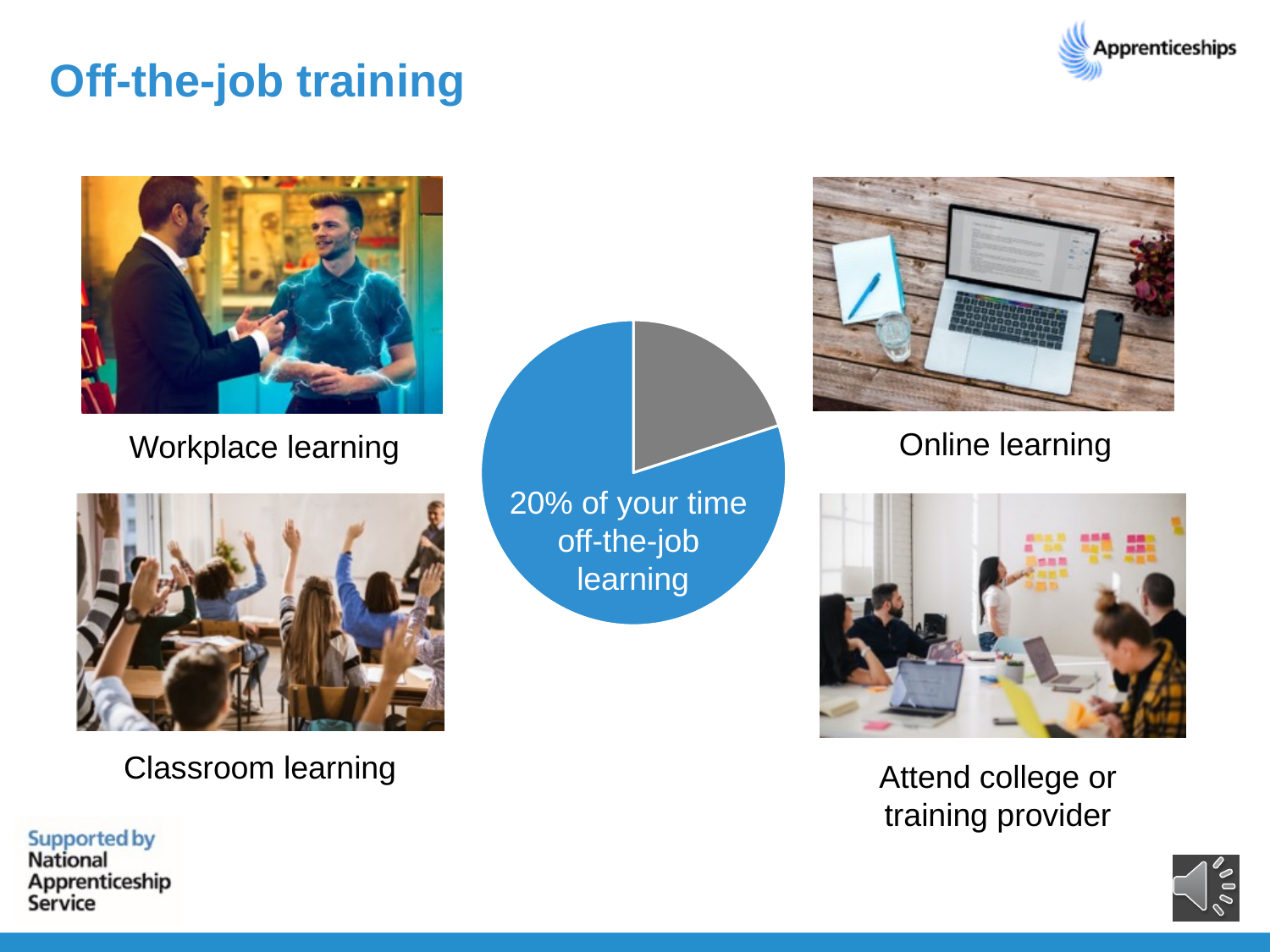
According to the text on the pie chart, what percentage of your time is off-the-job learning? 20% Is the blue slice of the pie chart greater or less than 50% of the pie? greater What text is written on the pie chart? 20% of your time off-the-job learning Is the grey slice of the pie chart greater or less than 50% of the pie? less Which slice of the pie chart is larger, the blue one or the grey one? blue Which colour slice is the largest in the pie chart? blue What is the title of the slide containing the pie chart? Off-the-job training Which colour slice is the smallest in the pie chart? grey What kind of chart is shown in the centre of the slide? pie chart How many slices does the pie chart have? 2